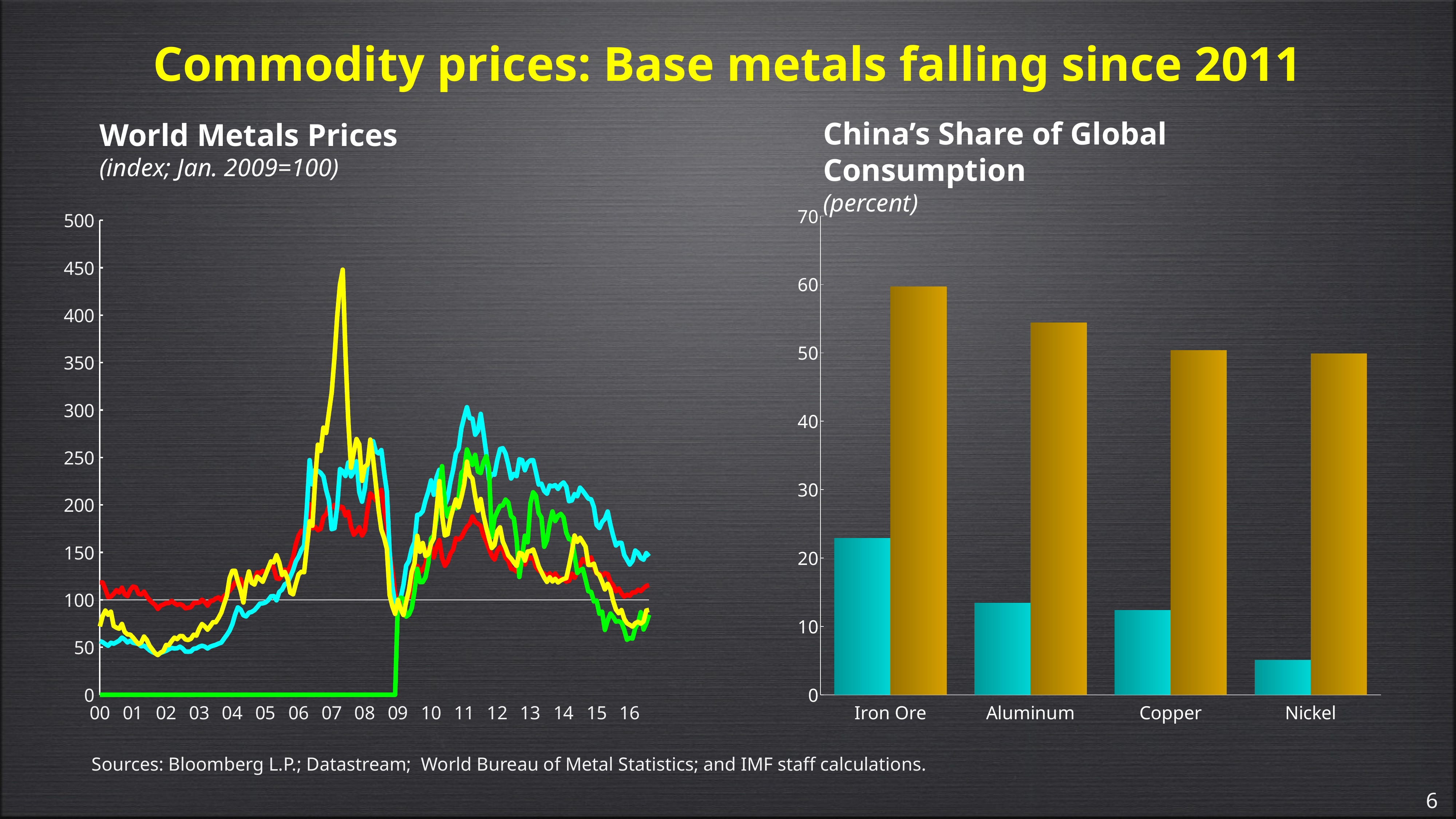
In the China's Share of Global Consumption chart, which category has the shortest cyan bar? Nickel In the China's Share of Global Consumption chart, is the cyan bar for Nickel greater or less than 10? less What kind of chart is the China's Share of Global Consumption chart on the right? bar chart In the World Metals Prices chart, do the lines generally rise or fall between 2011 and 2016? fall In the China's Share of Global Consumption chart, is the gold bar for Aluminum greater or less than 50? greater What is the subtitle shown under the World Metals Prices chart title? (index; Jan. 2009=100) In the China's Share of Global Consumption chart, how many categories are shown on the x axis? 4 In the World Metals Prices chart, is the highest point reached by any line greater or less than 400? greater In the China's Share of Global Consumption chart, which category has the tallest gold bar? Iron Ore In the China's Share of Global Consumption chart, which is larger: the cyan bar for Iron Ore or the cyan bar for Aluminum? Iron Ore What kind of chart is the World Metals Prices chart on the left? line chart